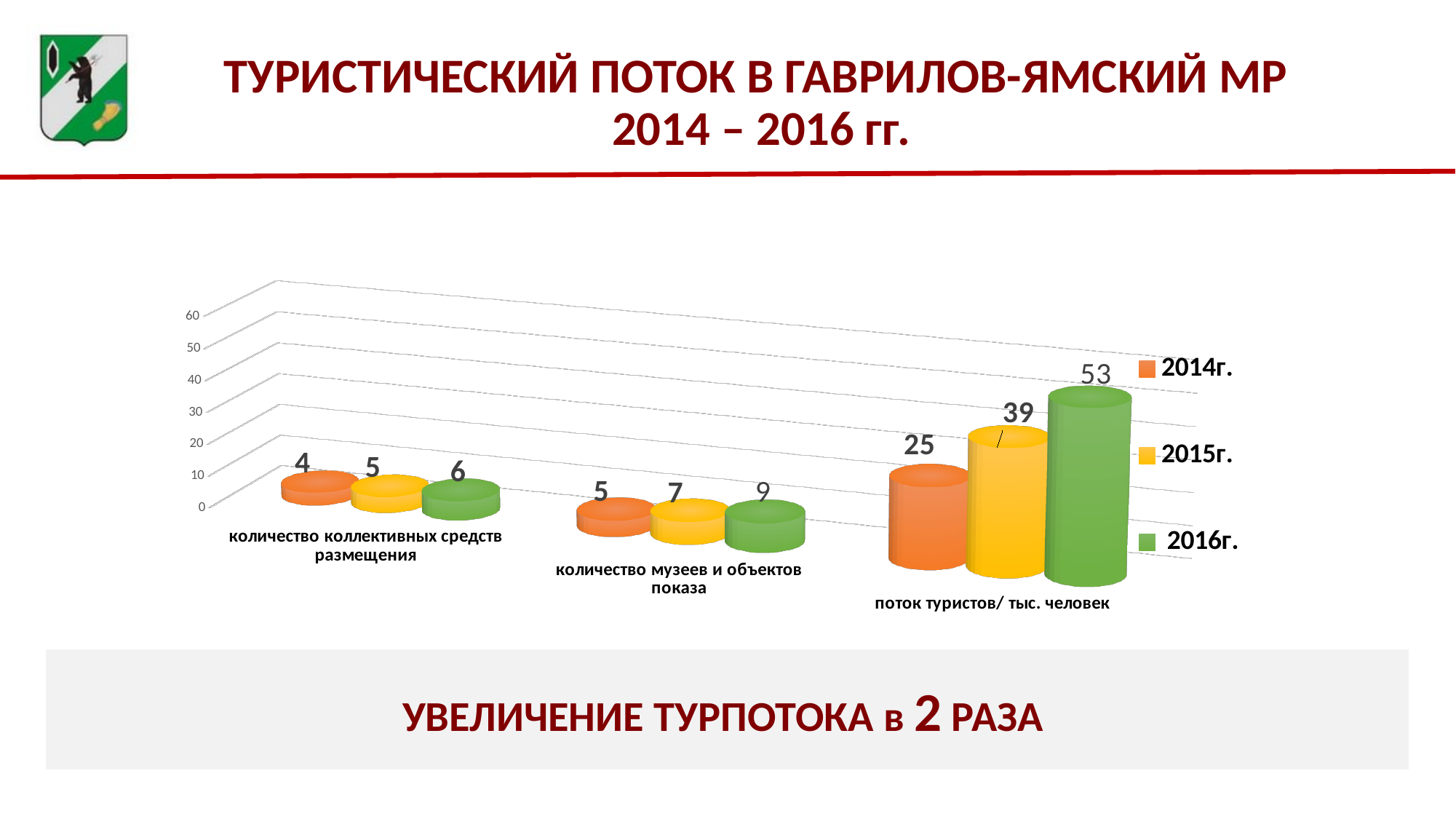
Which year has the lowest value in the category "количество музеев и объектов показа"? 2014г. Which year has the highest value in the category "поток туристов/ тыс. человек"? 2016г. Do the values for "поток туристов/ тыс. человек" rise or fall from 2014г. to 2016г.? rise What is the value for 2015г. in the category "количество коллективных средств размещения"? 5 What is the value for 2014г. in the category "количество музеев и объектов показа"? 5 What is the value for 2016г. in the category "поток туристов/ тыс. человек"? 53 Which is larger: the 2015г. value for "поток туристов/ тыс. человек" or the 2016г. value for "количество музеев и объектов показа"? 2015г. value for поток туристов/ тыс. человек How many categories are shown on the x axis? 3 What is the difference between the 2016г. and 2014г. values for "поток туристов/ тыс. человек"? 28 What is the difference between the 2015г. and 2014г. values for "количество музеев и объектов показа"? 2 How many series does the legend list? 3 What kind of chart is shown on the slide? bar chart